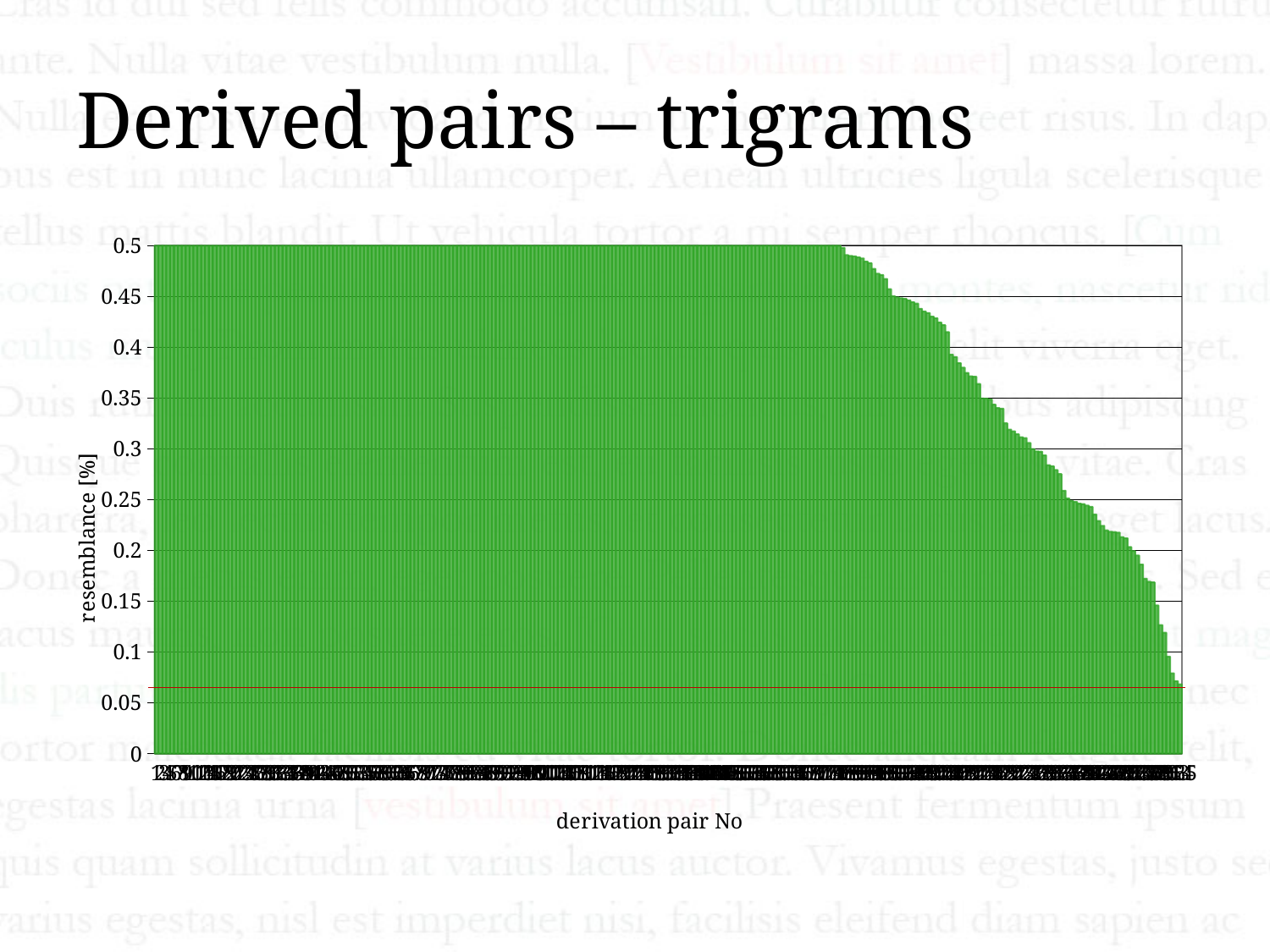
What is the label of the vertical axis? resemblance [%] Are the bars on the left side of the chart taller or shorter than the bars on the right side? taller What kind of chart is shown on the slide? bar chart What is the label of the horizontal axis? derivation pair No Do the bar values rise or fall moving from left to right along the x axis? fall Is the value of the shortest bar (at the far right) greater or less than 0.1? less Is the value of the shortest bar (at the far right) greater or less than 0.05? greater What is the highest tick value shown on the vertical axis? 0.5 Is the value of the bars at the far left of the chart greater or less than 0.45? greater